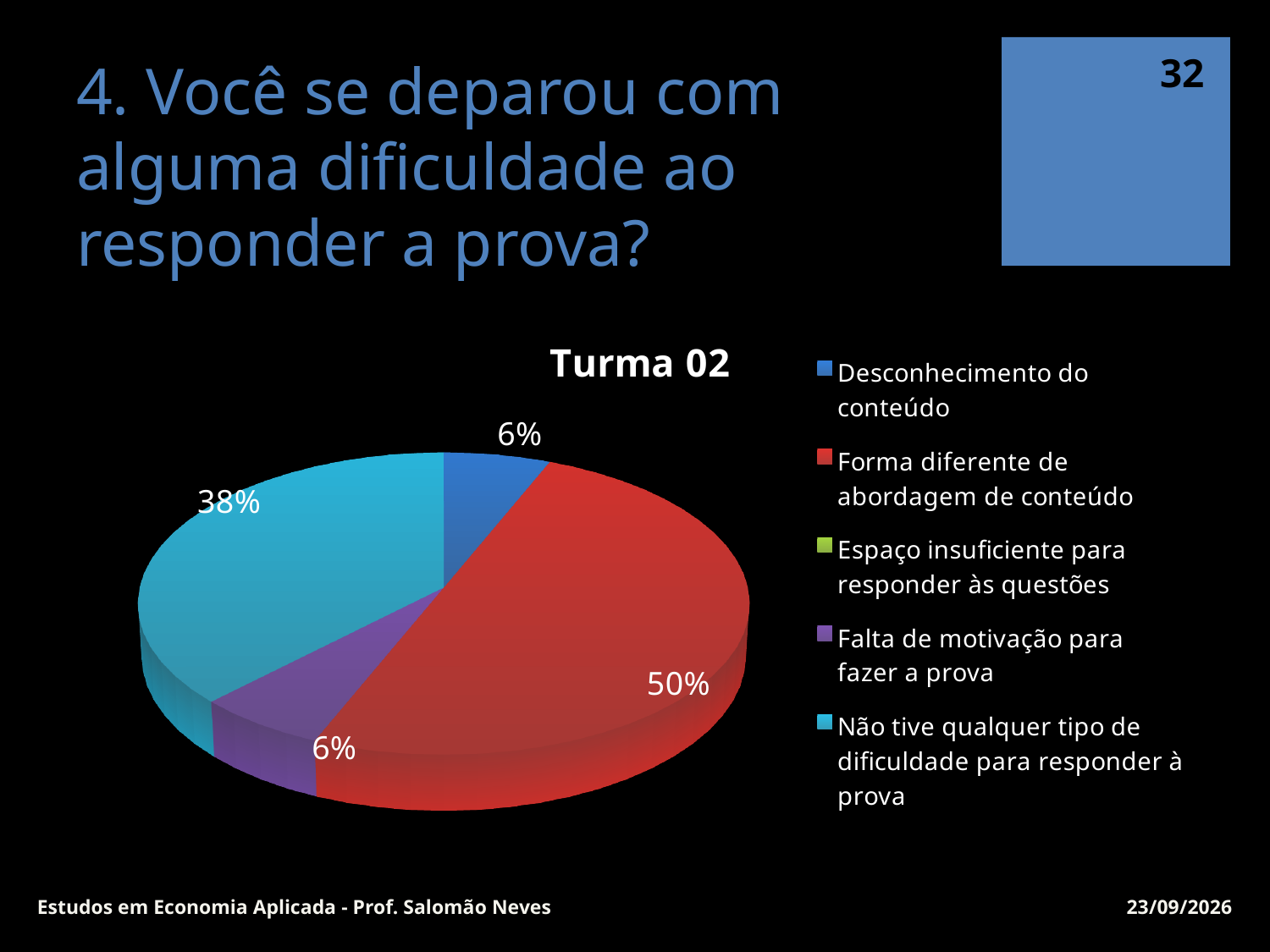
How many entries does the chart's legend list? 5 What is the difference in percentage points between 'Forma diferente de abordagem de conteúdo' and 'Não tive qualquer tipo de dificuldade para responder à prova'? 12 percentage points What share of the pie is 'Não tive qualquer tipo de dificuldade para responder à prova'? 38% Which is larger: the slice for 'Não tive qualquer tipo de dificuldade para responder à prova' or the slice for 'Desconhecimento do conteúdo'? Não tive qualquer tipo de dificuldade para responder à prova Which category has the largest slice of the pie? Forma diferente de abordagem de conteúdo How many slices with a percentage label are visible in the pie? 4 What kind of chart is shown on the slide? pie chart What is the title of the chart? Turma 02 What share of the pie is 'Falta de motivação para fazer a prova'? 6% What colour is the slice for 'Forma diferente de abordagem de conteúdo'? red What share of the pie is 'Desconhecimento do conteúdo'? 6%